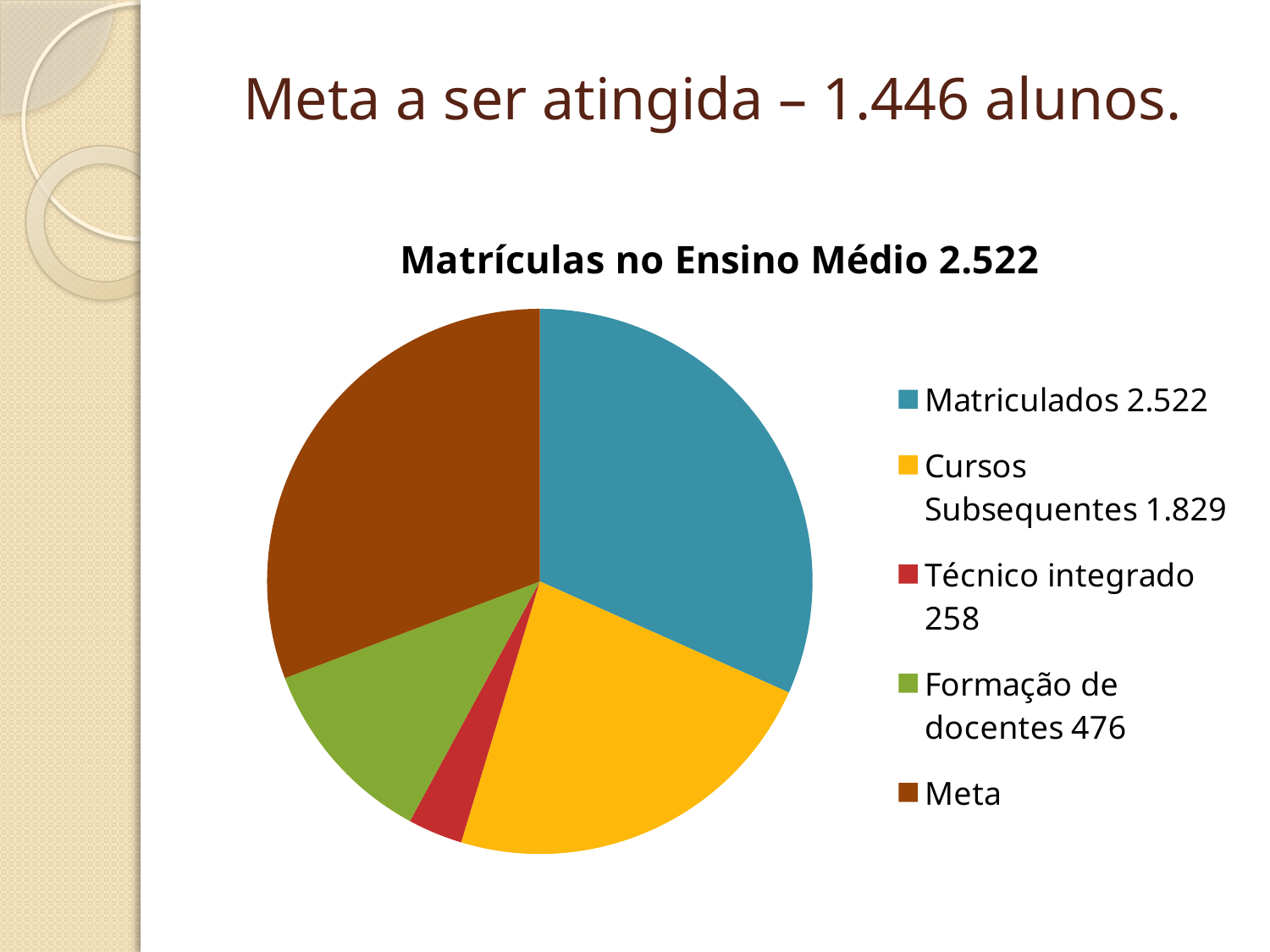
Which category has the smallest slice of the pie? Técnico integrado 258 What value is given for Técnico integrado in the legend? 258 How many entries does the legend list? 5 What is the title of the chart? Matrículas no Ensino Médio 2.522 What value is given for Matriculados in the legend? 2.522 What value is given for Cursos Subsequentes in the legend? 1.829 How many slices does the pie chart have? 5 What value is given for Formação de docentes in the legend? 476 What kind of chart is shown on the slide? pie chart Which is larger, Formação de docentes or Técnico integrado? Formação de docentes What is the difference between the Matriculados value and the Cursos Subsequentes value? 693